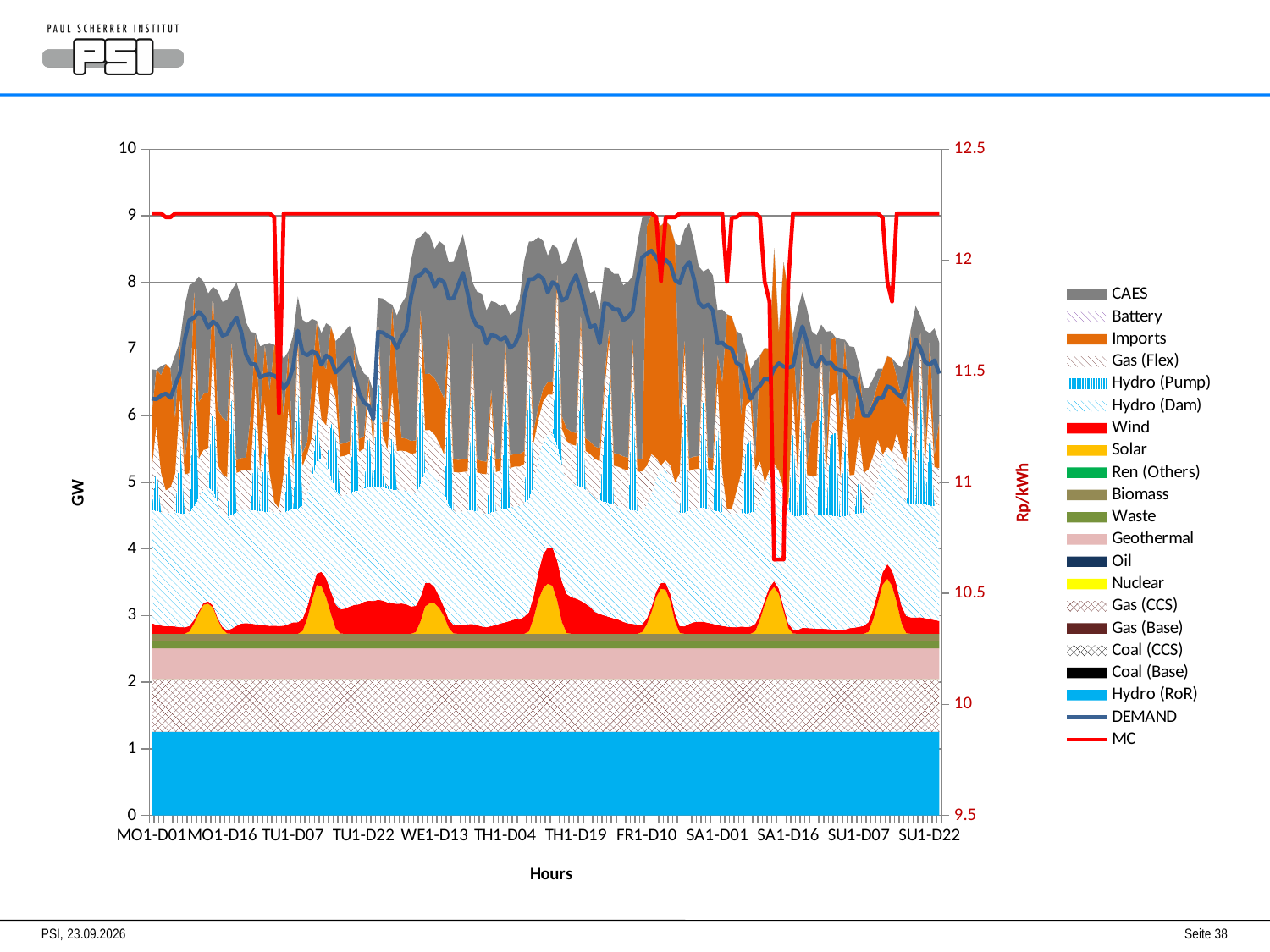
At its highest point near FR1-D10, is the DEMAND line greater or less than 8 GW? greater How many series does the legend list? 21 For most hours, is the MC line greater or less than 12 Rp/kWh? greater What is the label of the right-hand y axis? Rp/kWh How many tick labels are shown along the x axis? 12 What kind of chart is shown on the slide? stacked area chart with line overlays Is the MC value at its dip near SA1-D16 larger or smaller than the MC value at MO1-D01? smaller What is the title of the x axis? Hours Is the DEMAND line at MO1-D01 greater or less than 7 GW? less